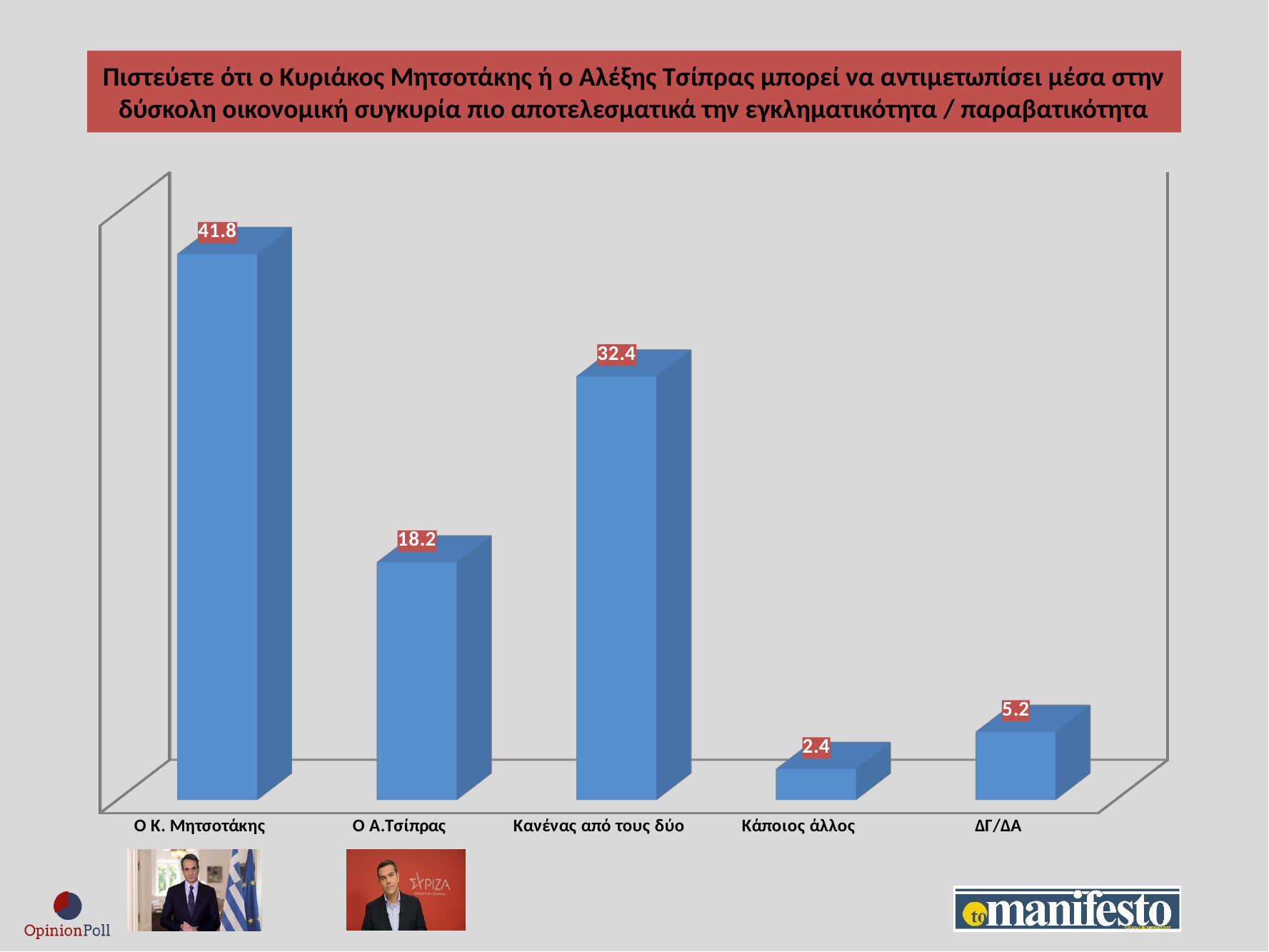
What is the value for ΔΓ/ΔΑ? 5.2 What is the value for Κάποιος άλλος? 2.4 What is the value for Ο Α.Τσίπρας? 18.2 What is the difference between the values for ΔΓ/ΔΑ and Κάποιος άλλος? 2.8 What kind of chart is shown on the slide? Bar chart What is the value for Κανένας από τους δύο? 32.4 Which category has the lowest value? Κάποιος άλλος What is the difference between the values for Ο Κ. Μητσοτάκης and Ο Α.Τσίπρας? 23.6 Which category has the highest value? Ο Κ. Μητσοτάκης How many categories are shown in the chart? 5 Which is larger, the value for Κανένας από τους δύο or the value for Ο Α.Τσίπρας? Κανένας από τους δύο What is the value for Ο Κ. Μητσοτάκης? 41.8